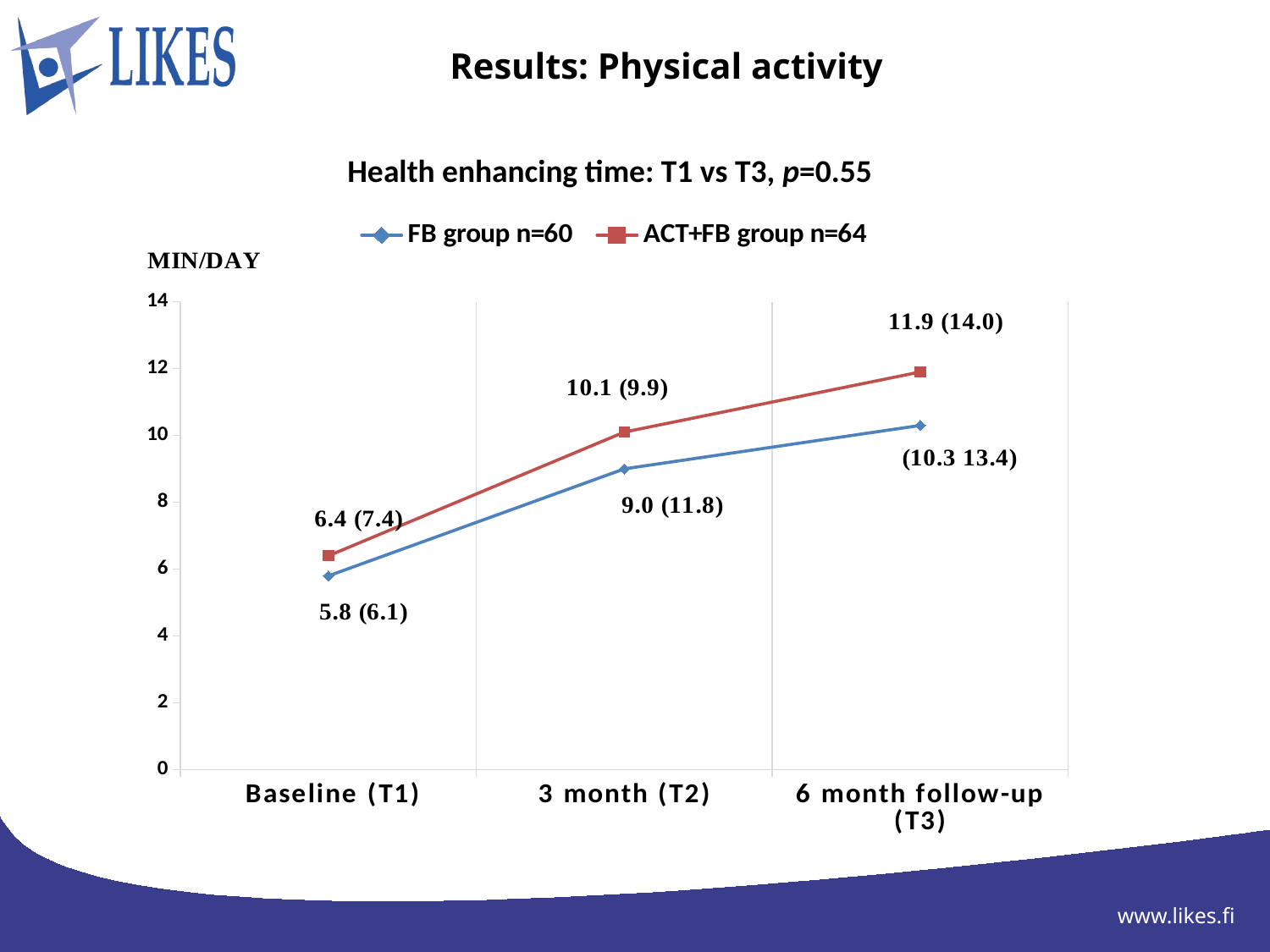
How many series does the legend list? 2 Which series has the higher plotted value at 3 month (T2)? ACT+FB group n=64 What is the plotted value for the FB group n=60 at Baseline (T1)? 5.8 What is the plotted value for the ACT+FB group n=64 at 6 month follow-up (T3)? 11.9 What type of chart is shown on the slide? Line chart What is the full data label shown for the ACT+FB group n=64 at 3 month (T2)? 10.1 (9.9) Do the values for both series rise or fall from Baseline (T1) to 6 month follow-up (T3)? Rise Which series and time point has the lowest plotted value on the chart? FB group n=60 at Baseline (T1) How many time points are plotted along the x axis? 3 What is the difference between the ACT+FB group and the FB group plotted values at 6 month follow-up (T3)? 1.6 By how much does the FB group n=60 plotted value increase from Baseline (T1) to 6 month follow-up (T3)? 4.5 What unit is shown on the y axis of the chart? MIN/DAY